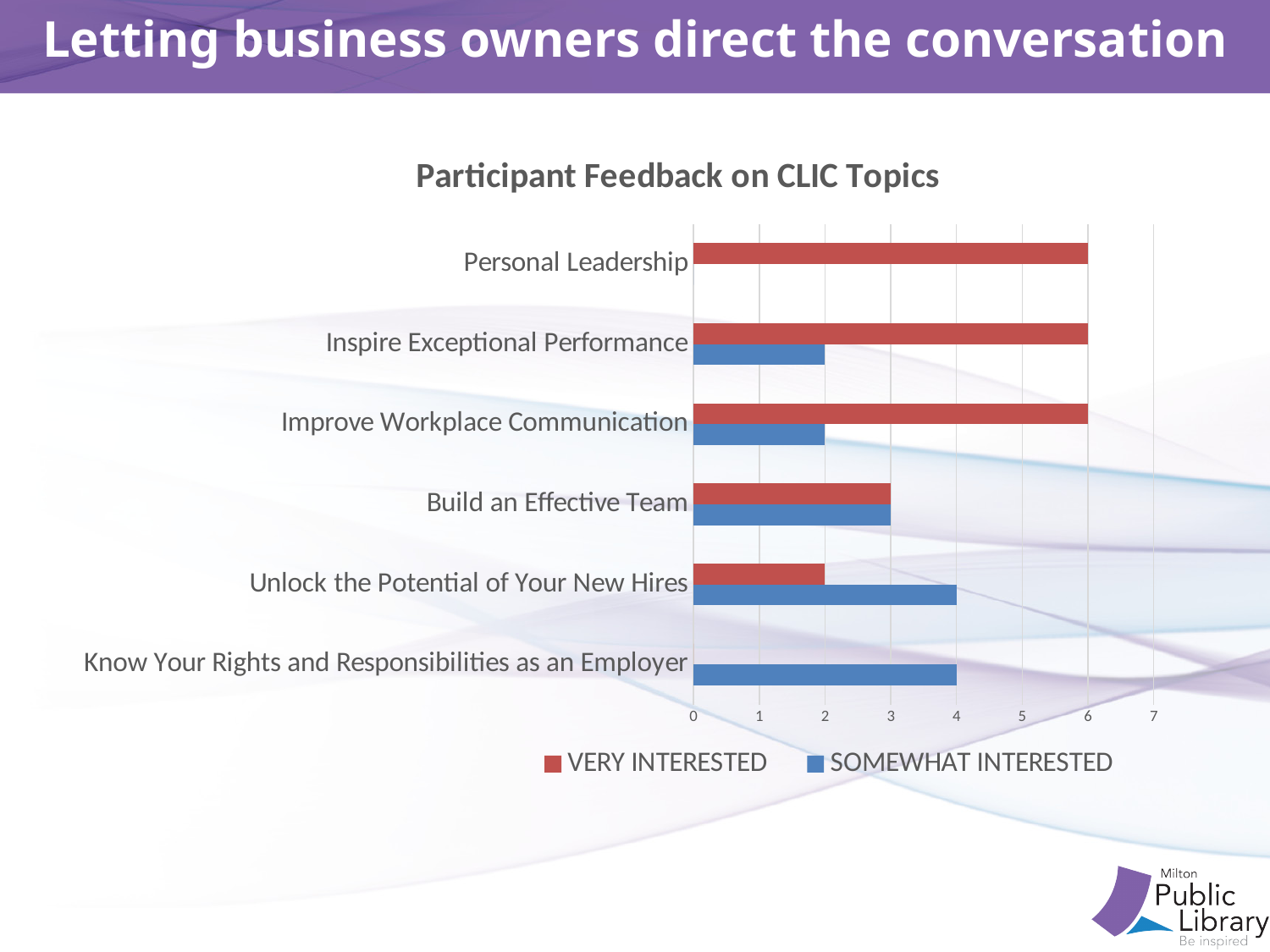
What kind of chart is shown on the slide? Bar chart What is the SOMEWHAT INTERESTED value for Unlock the Potential of Your New Hires? 4 Which topic has the highest SOMEWHAT INTERESTED value among those with a visible bar, Build an Effective Team or Unlock the Potential of Your New Hires? Unlock the Potential of Your New Hires Which topic has the lowest VERY INTERESTED value? Know Your Rights and Responsibilities as an Employer Which colour represents the SOMEWHAT INTERESTED series? Blue How many topics (categories) are shown on the chart? 6 What is the title of the chart? Participant Feedback on CLIC Topics How many series does the legend list? 2 What is the VERY INTERESTED value for Personal Leadership? 6 Is the VERY INTERESTED value for Improve Workplace Communication greater or less than 5? greater What is the difference between the VERY INTERESTED and SOMEWHAT INTERESTED values for Inspire Exceptional Performance? 4 What is the VERY INTERESTED value for Build an Effective Team? 3